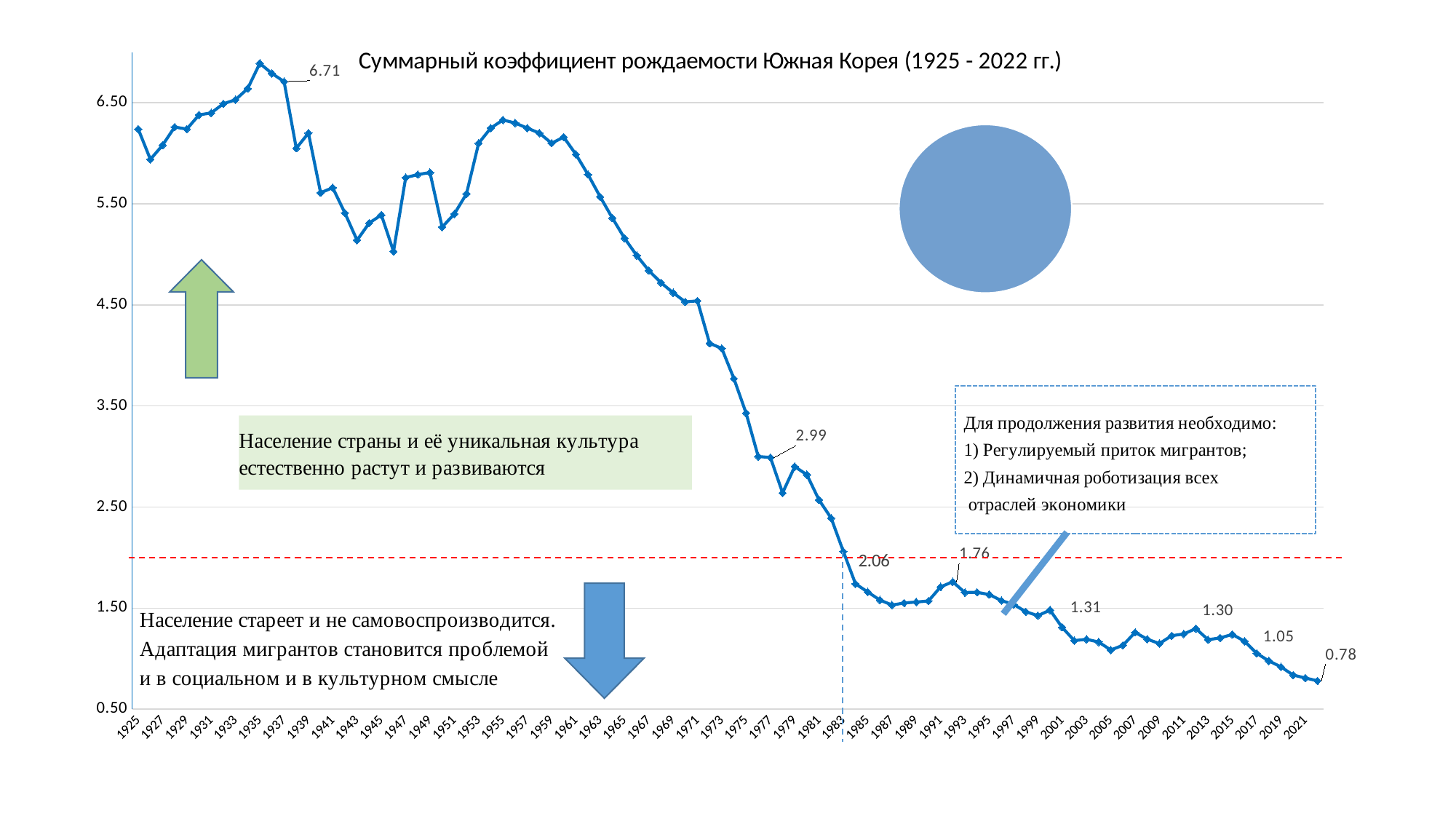
What is the value of the final data point on the right end of the line (2022)? 0.78 Is the value for 1965 greater or less than 5.50? less Overall, do the values rise or fall from 1925 to 2022? fall What kind of chart is shown on the slide? line chart Is the value for 2005 greater or less than 1.50? less What is the largest value printed as a data label on the chart? 6.71 In which year does the line reach its lowest value? 2022 What is the title of the chart? Суммарный коэффициент рождаемости Южная Корея (1925 - 2022 гг.) What is the difference between the labeled values 2.99 and 2.06? 0.93 Is the value for 1925 greater or less than 5.50? greater Which year has a higher value, 1955 or 1975? 1955 What is the difference between the labeled values 6.71 and 0.78? 5.93